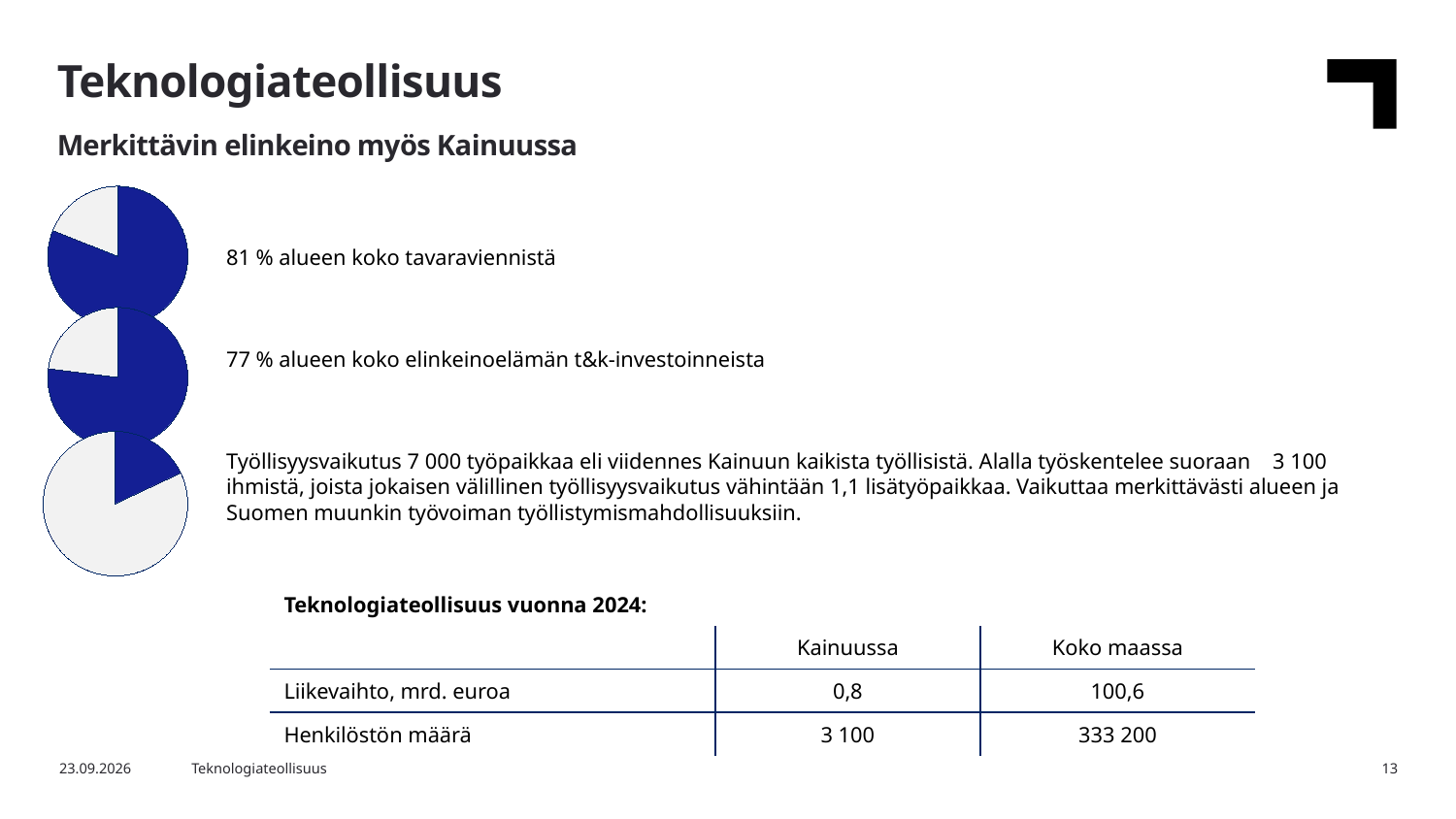
How many slices does the top pie chart have? 2 In the top pie chart, is the dark blue slice larger or smaller than the light grey slice? Larger What kind of chart is shown at the top left of the slide? Pie chart What does the top pie chart illustrate, according to the text next to it? 81 % alueen koko tavaraviennistä Which pie chart has the larger dark blue slice, the top one or the bottom one? The top one Which of the three pie charts has the smallest dark blue slice? The bottom one How many pie charts are on the slide? 3 According to the text beside the middle pie chart, what share of the region's business R&D investments does the dark blue slice represent? 77 % What colour is the larger slice in the middle pie chart? Dark blue In the bottom pie chart, is the dark blue slice larger or smaller than the light grey slice? Smaller According to the text beside the top pie chart, what share of the region's total goods exports does the dark blue slice represent? 81 %